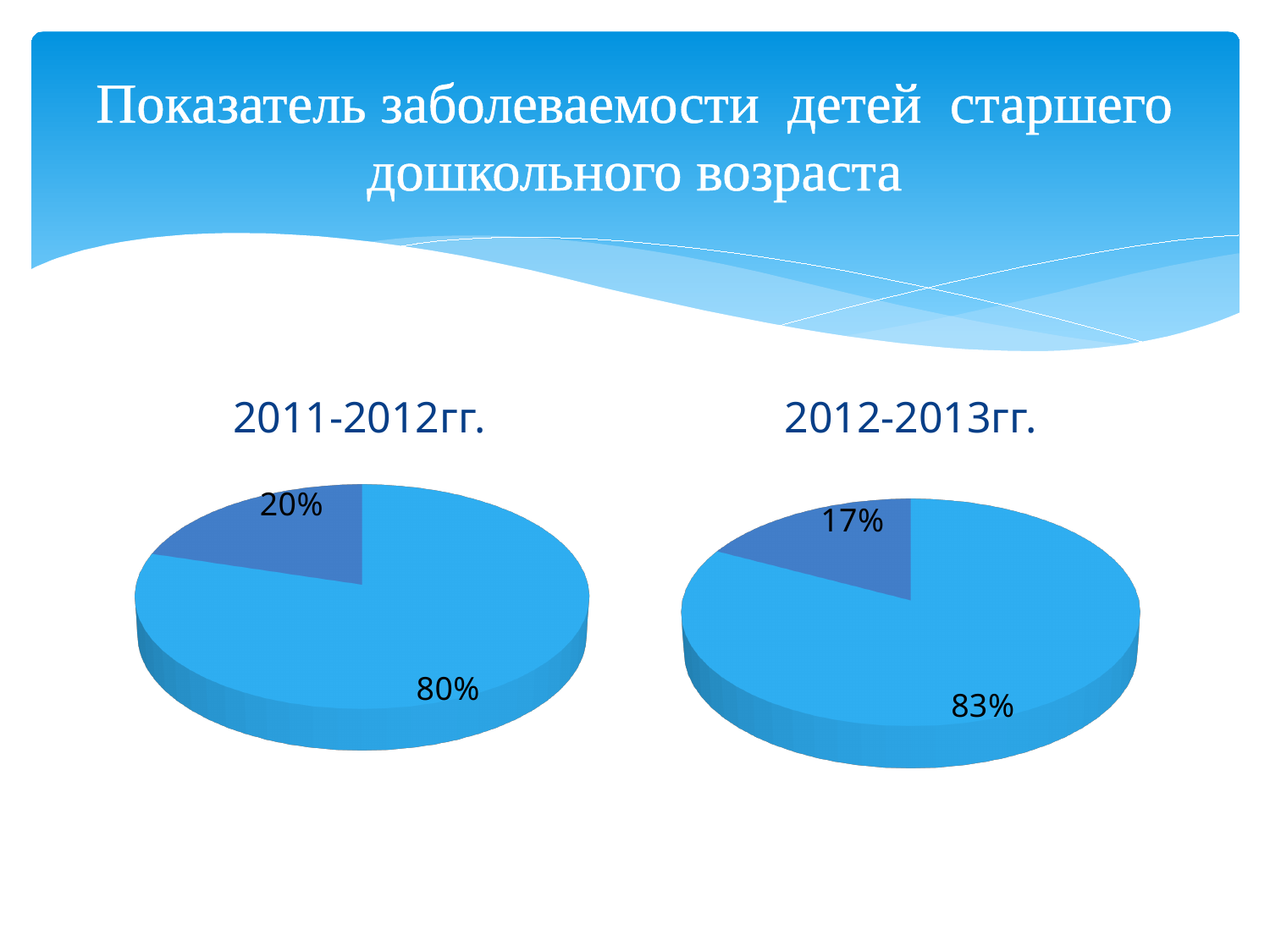
What kind of chart is the "2012-2013гг." chart? pie chart In the "2011-2012гг." chart, what is the value of the smaller (dark blue) slice? 20% In the "2012-2013гг." chart, what is the value of the smaller (dark blue) slice? 17% In the "2011-2012гг." chart, what is the value of the larger (light blue) slice? 80% In the "2012-2013гг." chart, what is the value of the larger (light blue) slice? 83% Which chart has the larger dark blue slice, "2011-2012гг." or "2012-2013гг."? 2011-2012гг. How many pie charts are shown on the slide? 2 What kind of chart is the "2011-2012гг." chart? pie chart In the "2012-2013гг." chart, what is the difference between the larger and smaller slices? 66% How many slices does the "2011-2012гг." pie chart have? 2 In the "2011-2012гг." chart, what is the difference between the larger and smaller slices? 60% How many slices does the "2012-2013гг." pie chart have? 2